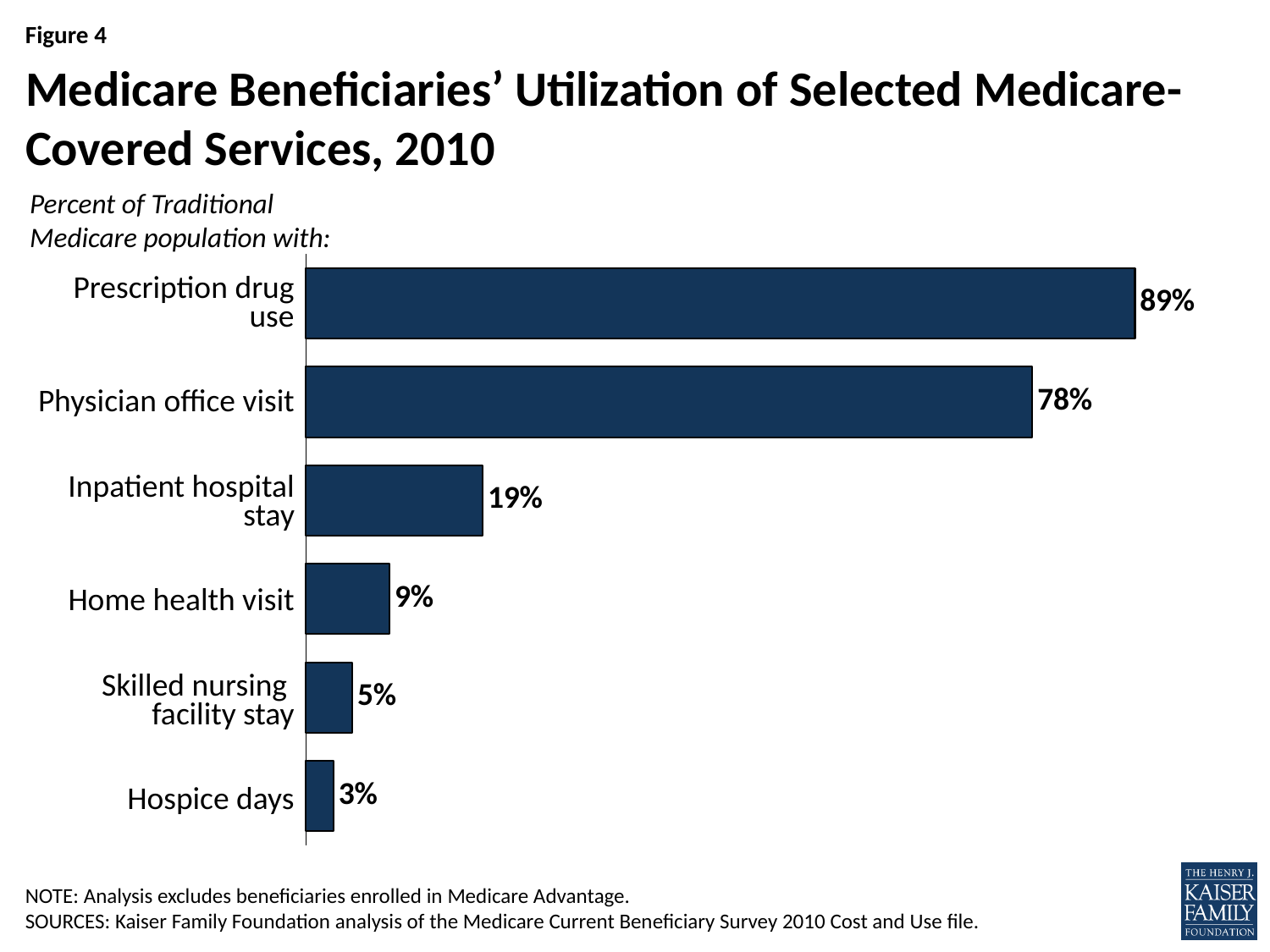
What percent of the Traditional Medicare population had a physician office visit? 78% What is the difference in percentage points between prescription drug use and physician office visit? 11 Which service has the lowest utilization percentage? Hospice days What percent of the Traditional Medicare population had prescription drug use? 89% What is the difference in percentage points between inpatient hospital stay and home health visit? 10 Which service has the highest utilization percentage? Prescription drug use What percent of the Traditional Medicare population had a skilled nursing facility stay? 5% Which is larger: the percentage with a home health visit or the percentage with hospice days? Home health visit What percent of the Traditional Medicare population had an inpatient hospital stay? 19% How many services are shown in the chart? 6 What is the figure number of this chart? Figure 4 What type of chart is shown on the slide? Bar chart